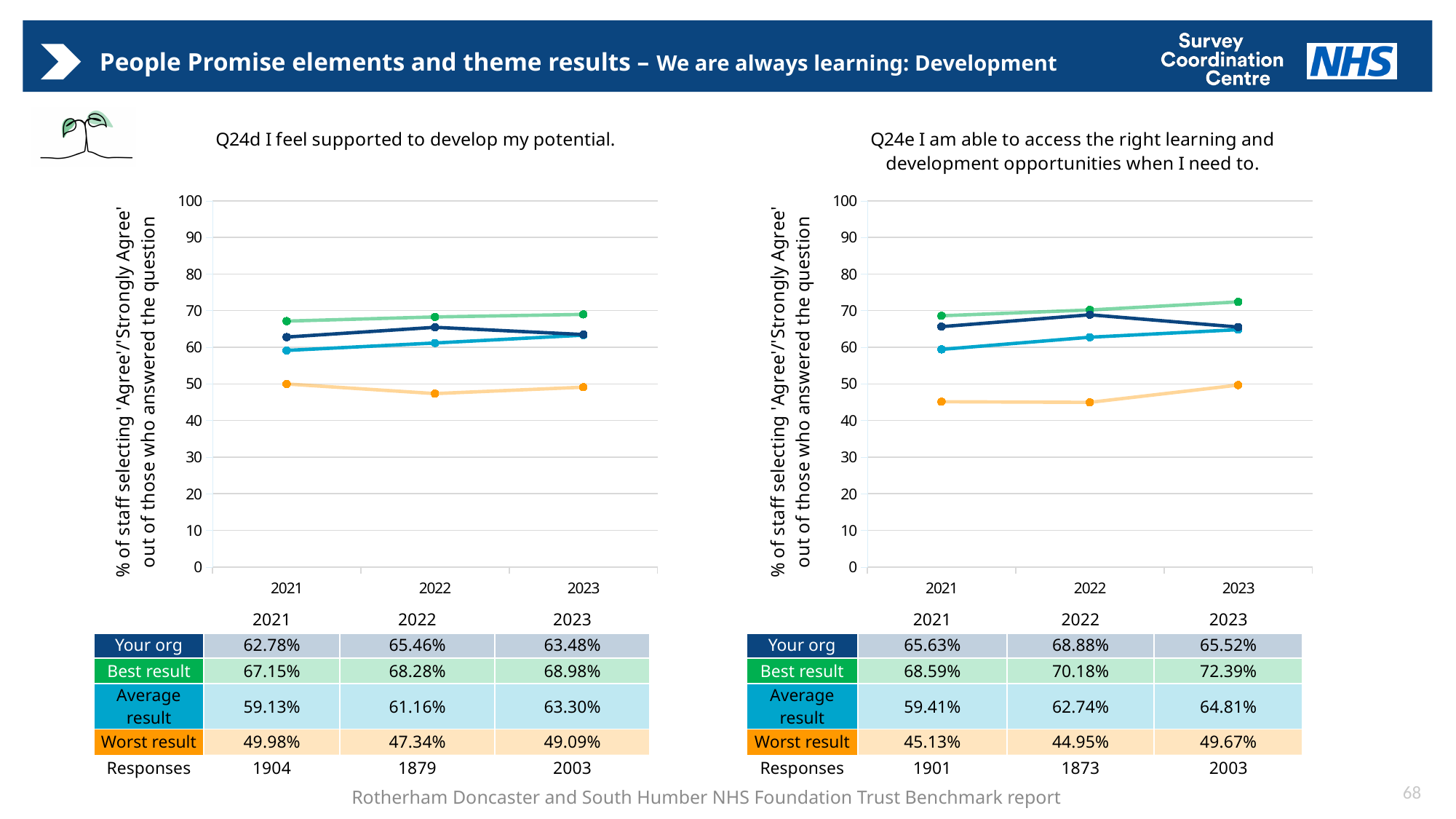
How many series are plotted in the Q24e chart? 4 In the Q24e chart, what is the 'Best result' value for 2023? 72.39% In the Q24e chart, in which year is the 'Worst result' value lowest? 2022 In the Q24d chart, what is the difference between the 'Best result' and 'Your org' values in 2023? 5.50% In the Q24d chart, what is the 'Worst result' value for 2022? 47.34% In the Q24e chart, does the 'Best result' line rise or fall from 2021 to 2023? rise In the Q24e chart, what is the 'Average result' value for 2021? 59.41% In the Q24e chart, which is larger in 2022: the 'Your org' value or the 'Average result' value? Your org In the Q24d chart, in which year is the 'Your org' value highest? 2022 What type of chart is used for Q24d? line chart How many years are plotted on the x axis of the Q24d chart? 3 In the Q24d chart, what is the 'Your org' value for 2022? 65.46%